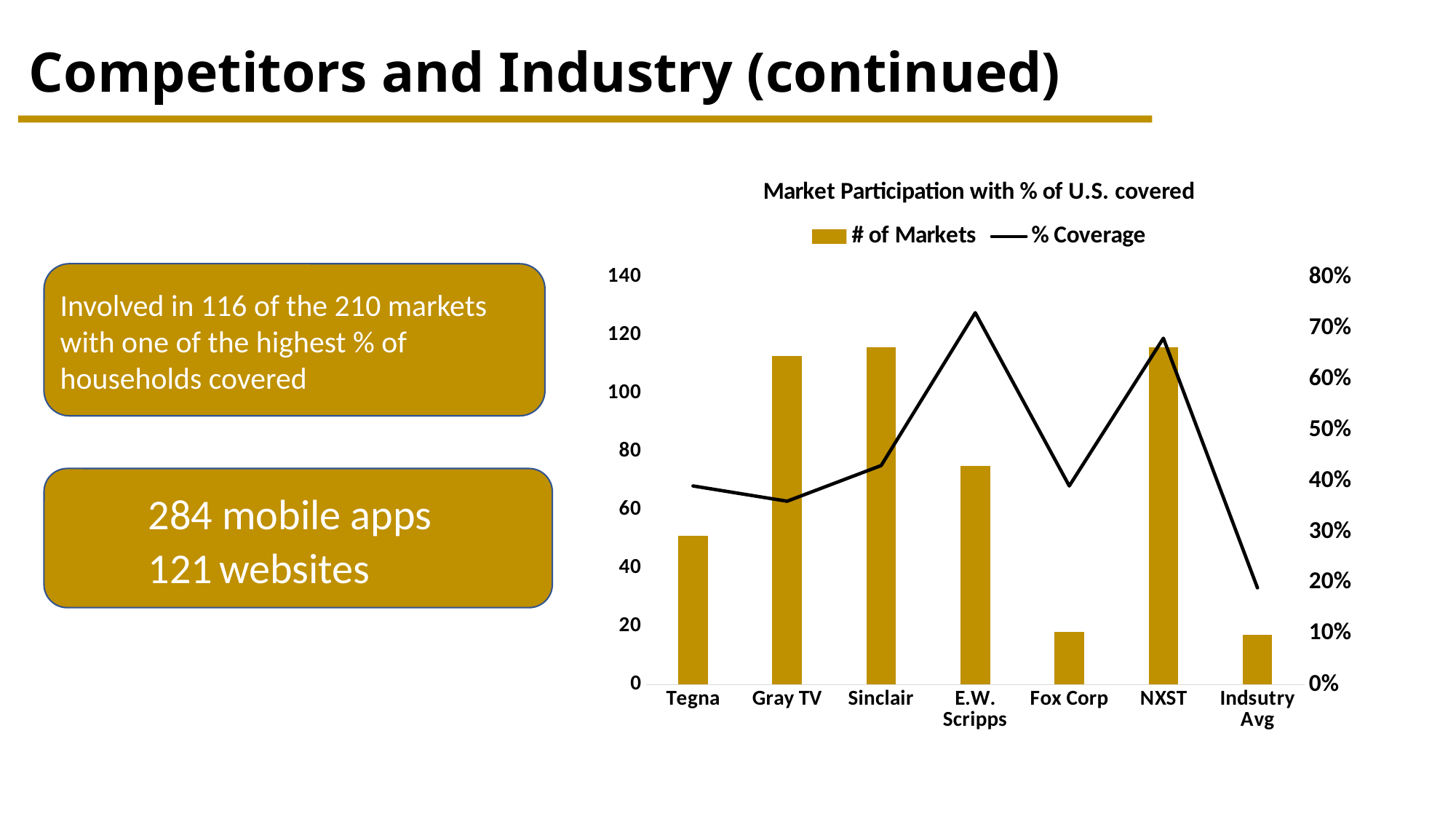
Which has a higher % Coverage, NXST or Gray TV? NXST Is the # of Markets for Gray TV greater or less than 100? greater What is the title of the chart? Market Participation with % of U.S. covered Which has more markets, Gray TV or Tegna? Gray TV What kind of chart is used to show the # of Markets series? Bar chart Is the # of Markets for Fox Corp greater or less than 40? less Is the # of Markets for Tegna greater or less than 60? less How many series does the chart legend list? 2 Which category has the lowest % Coverage? Indsutry Avg Which category has the highest % Coverage? E.W. Scripps How many categories are shown on the x axis of the chart? 7